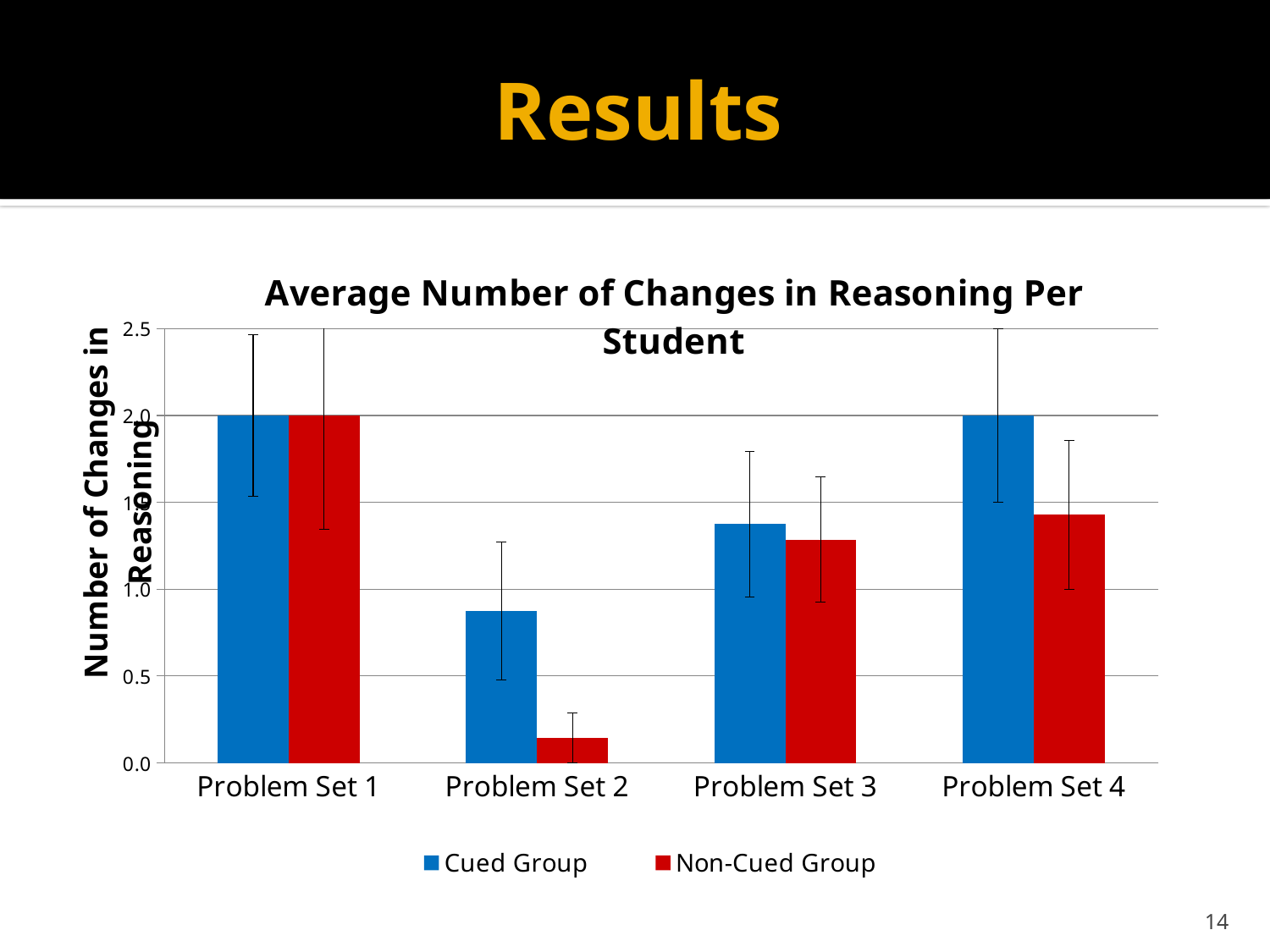
Is the value for the Cued Group in Problem Set 2 greater or less than 1.0? less How many problem sets are shown on the x axis? 4 Is the value for the Non-Cued Group in Problem Set 4 greater or less than 2.0? less What is the value for the Non-Cued Group in Problem Set 1? 2.0 What is the value for the Cued Group in Problem Set 1? 2.0 In Problem Set 4, which group has the larger value, Cued Group or Non-Cued Group? Cued Group What type of chart is shown on the slide? bar chart What is the title of the chart? Average Number of Changes in Reasoning Per Student How many series does the legend list? 2 What is the value for the Cued Group in Problem Set 4? 2.0 In which problem set is the Non-Cued Group value lowest? Problem Set 2 Is the value for the Non-Cued Group in Problem Set 2 greater or less than 0.5? less